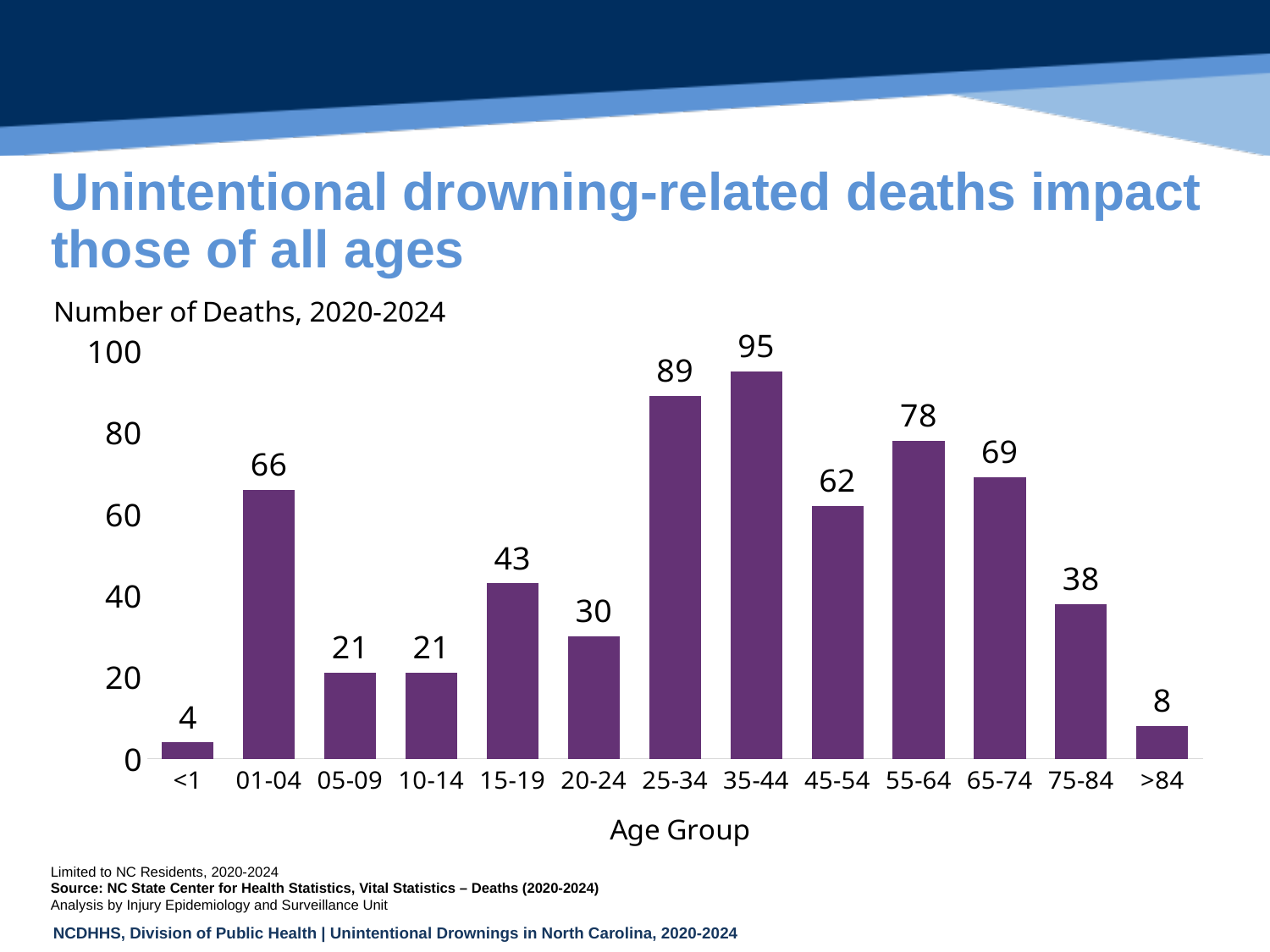
What is the number of deaths for the 55-64 age group? 78 What is the number of deaths for the 35-44 age group? 95 What is the number of deaths for the <1 age group? 4 How many age groups are shown on the x axis? 13 What is the difference in deaths between the 01-04 and 05-09 age groups? 45 Which age group has more deaths, 45-54 or 65-74? 65-74 What is the title of the chart? Number of Deaths, 2020-2024 What kind of chart is shown on the slide? Bar chart Which age group has the lowest number of deaths? <1 Which age group has the highest number of deaths? 35-44 What is the difference in deaths between the 25-34 and 20-24 age groups? 59